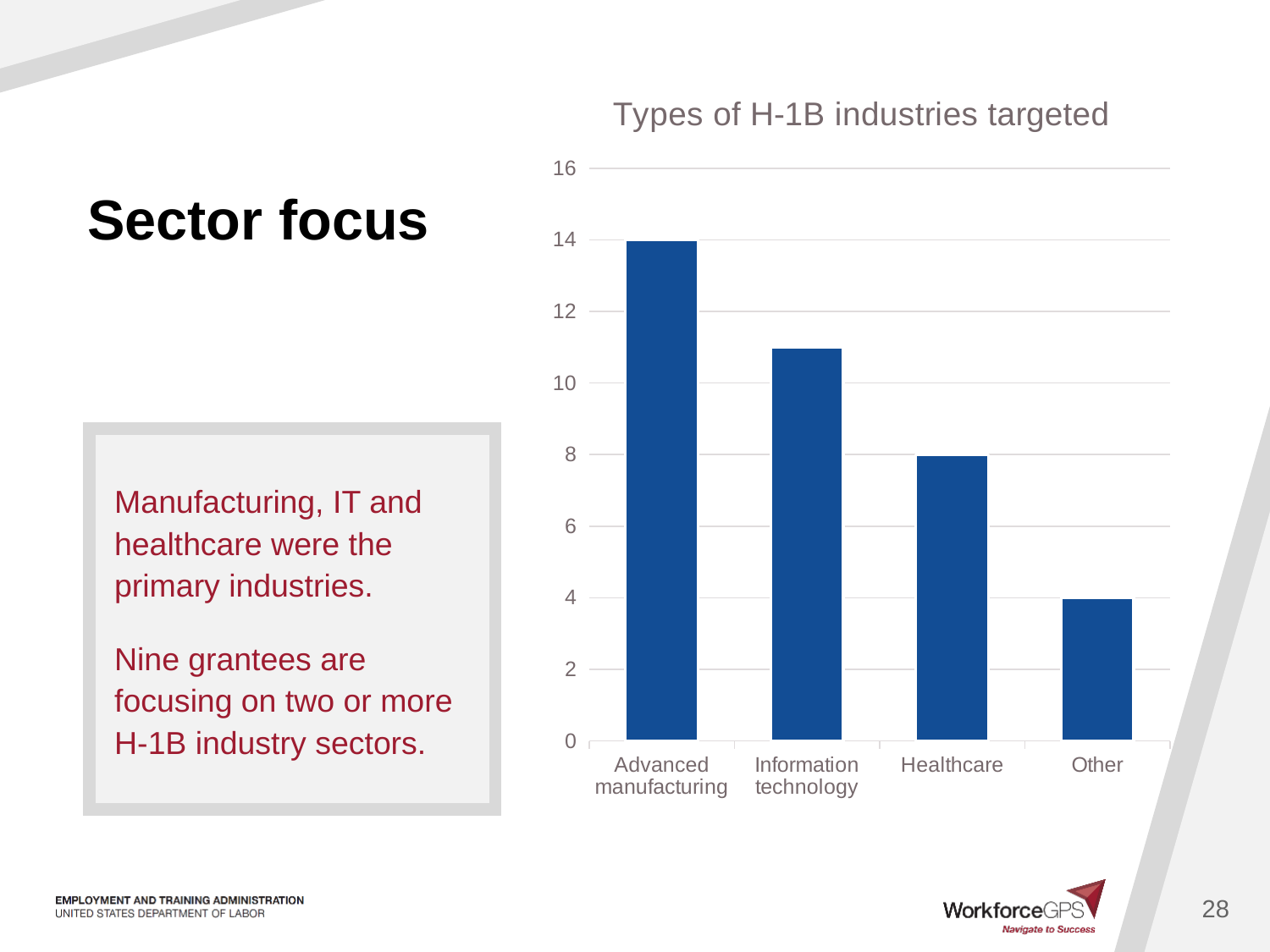
Is the value for Information technology greater or less than 10? greater How many industry categories are shown in the chart? 4 Which category has the lowest value? Other What type of chart is shown on the slide? bar chart What is the title of the chart? Types of H-1B industries targeted What is the value for Other? 4 Which industry has the highest value? Advanced manufacturing What is the value for Advanced manufacturing? 14 Which is larger, the value for Information technology or the value for Healthcare? Information technology What is the difference between the values for Advanced manufacturing and Healthcare? 6 Do the values rise or fall moving from left to right across the categories? fall What is the value for Healthcare? 8